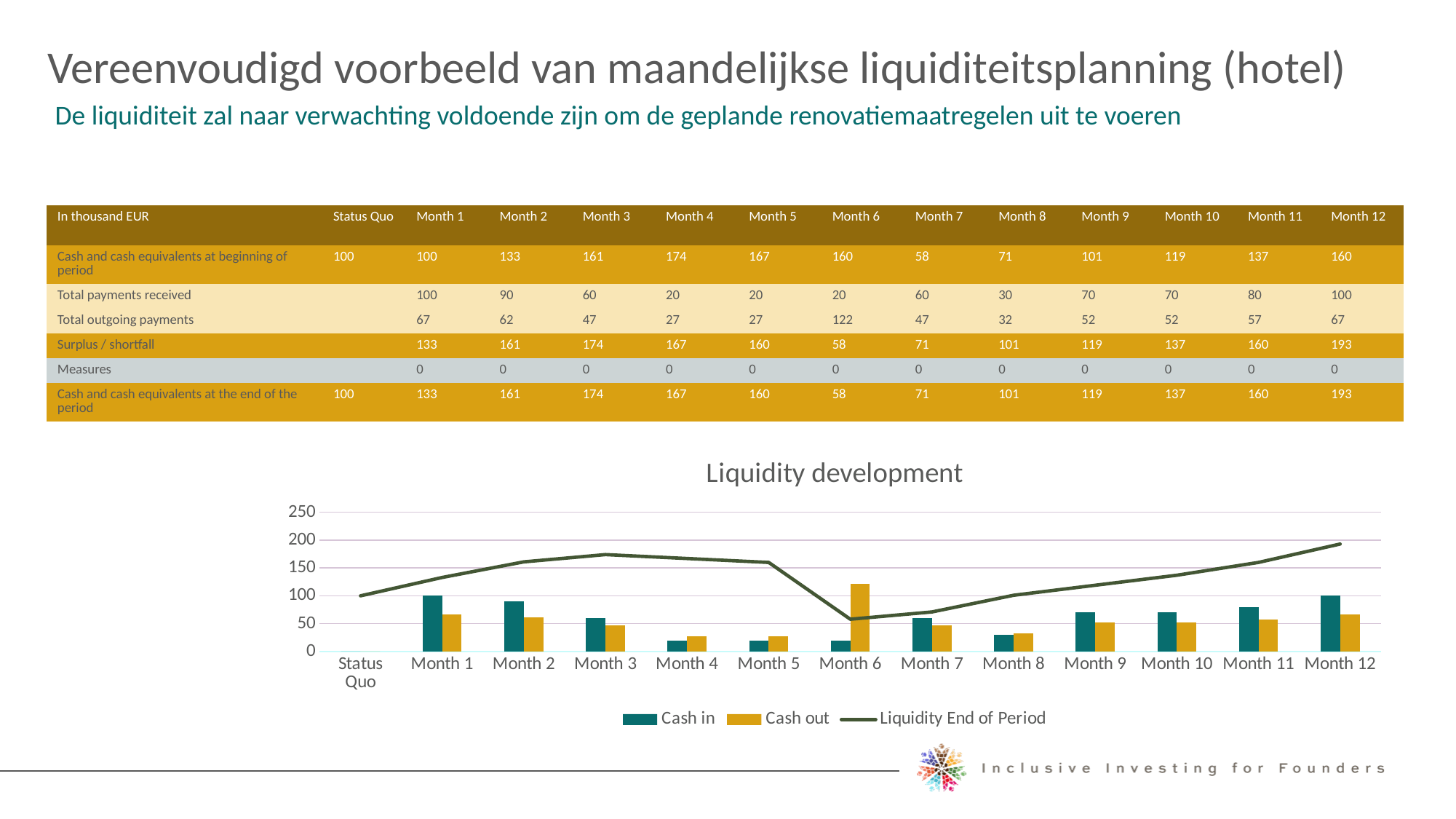
In the "Liquidity development" chart, at which month is the Liquidity End of Period line lowest? Month 6 What kind of chart is "Liquidity development"? A combined bar and line chart In the "Liquidity development" chart, which month has the highest Cash out bar? Month 6 In the "Liquidity development" chart, does the Liquidity End of Period line rise or fall from Month 6 to Month 12? Rises How many categories are shown on the x axis of the "Liquidity development" chart? 13 In the "Liquidity development" chart, what is the Cash out value for Month 6? 122 In the "Liquidity development" chart, which is larger for Month 2: Cash in or Cash out? Cash in In the "Liquidity development" chart, what is the Liquidity End of Period value at Status Quo? 100 In the "Liquidity development" chart, is the Cash in value for Month 4 greater or less than 50? less In the "Liquidity development" chart, at which month is the Liquidity End of Period line highest? Month 12 How many series does the legend of the "Liquidity development" chart list? 3 In the "Liquidity development" chart, is the Liquidity End of Period value for Month 3 greater or less than 150? greater